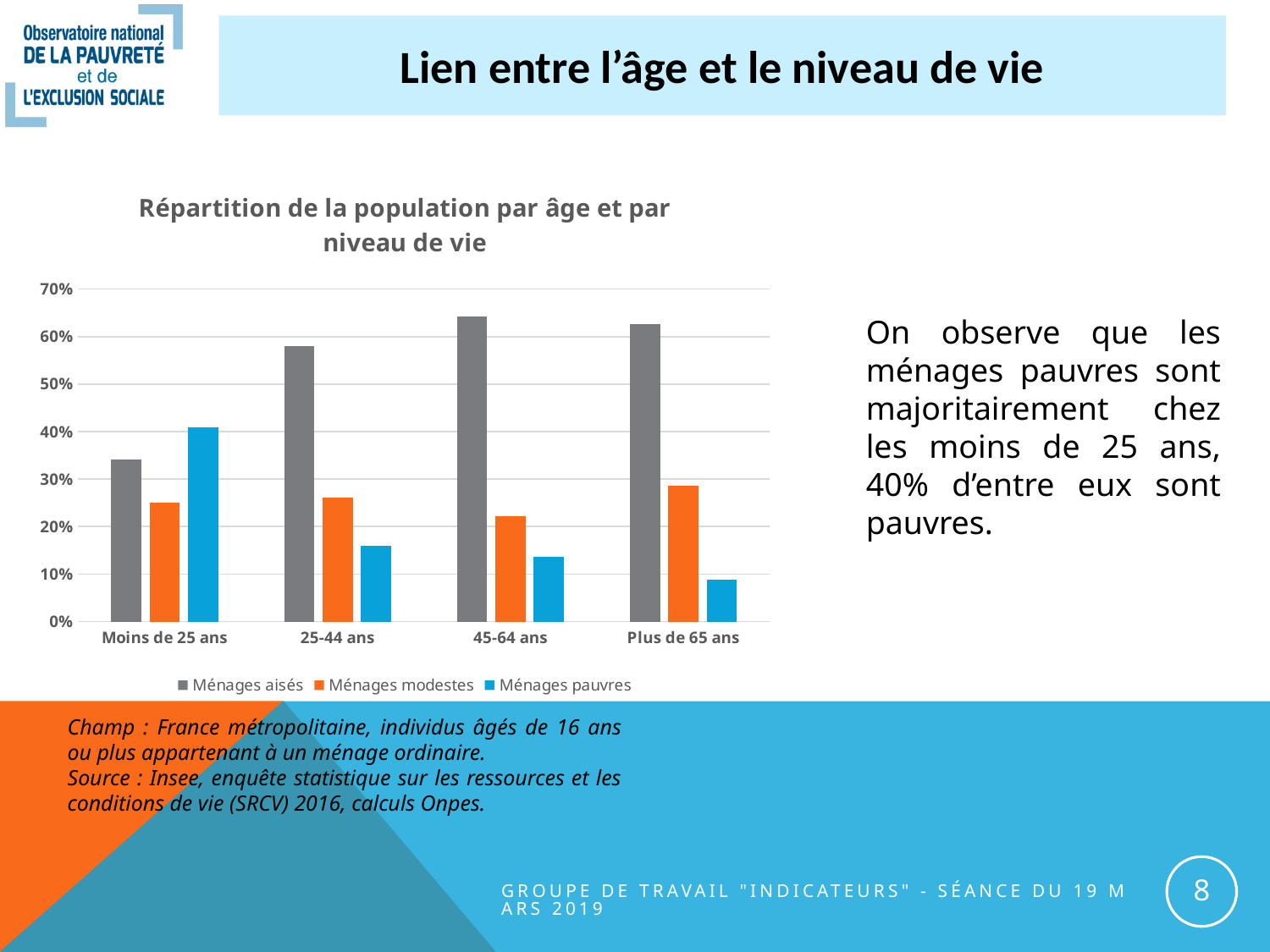
In the Moins de 25 ans category, which is larger: Ménages aisés or Ménages pauvres? Ménages pauvres Which age category has the highest value for Ménages pauvres? Moins de 25 ans Which age category has the lowest value for Ménages pauvres? Plus de 65 ans Do the values for Ménages pauvres rise or fall across the age categories from left to right? Fall How many series does the legend list? 3 Which age category has the lowest value for Ménages aisés? Moins de 25 ans Is the value for Ménages pauvres in the Plus de 65 ans category greater or less than 10%? less What kind of chart is shown on the slide? Bar chart Is the value for Ménages aisés in the 25-44 ans category greater or less than 50%? greater Which age category has the highest value for Ménages modestes? Plus de 65 ans How many age categories are shown on the x axis? 4